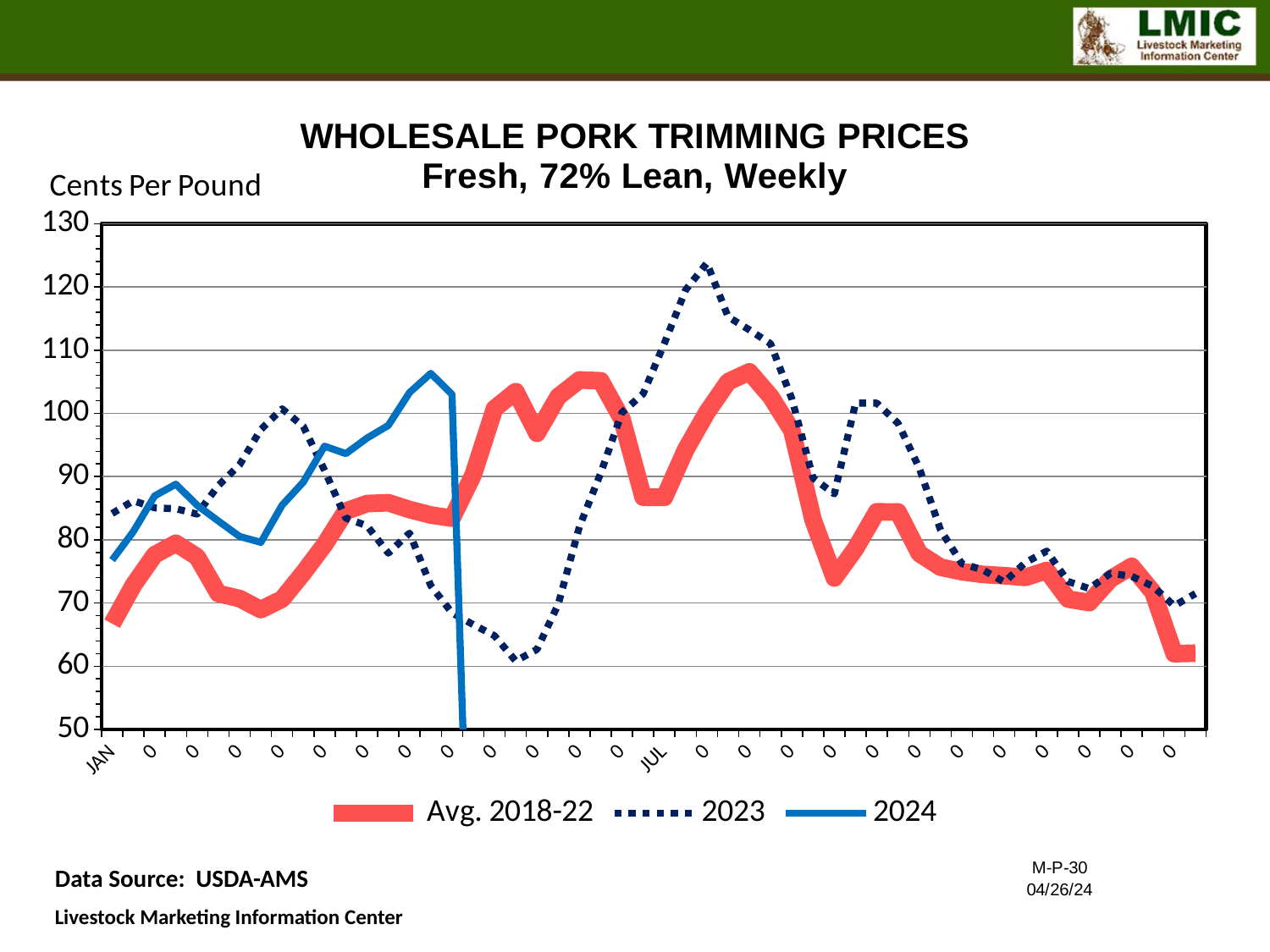
What are the three series listed in the legend? Avg. 2018-22, 2023, 2024 Is the value for the Avg. 2018-22 series at JAN greater or less than 70? less What kind of chart is shown on the slide? line chart Is the value for the 2024 series at JAN greater or less than 80? less Is the peak value of the 2023 series greater or less than 120? greater What is the unit label shown on the y axis of the chart? Cents Per Pound At JUL, which series is higher: 2023 or Avg. 2018-22? 2023 Which series reaches the highest value anywhere on the chart? 2023 How many series does the legend list? 3 Does the Avg. 2018-22 series generally rise or fall from JUL to the end of the year? fall At JAN, which series is higher: 2023 or Avg. 2018-22? 2023